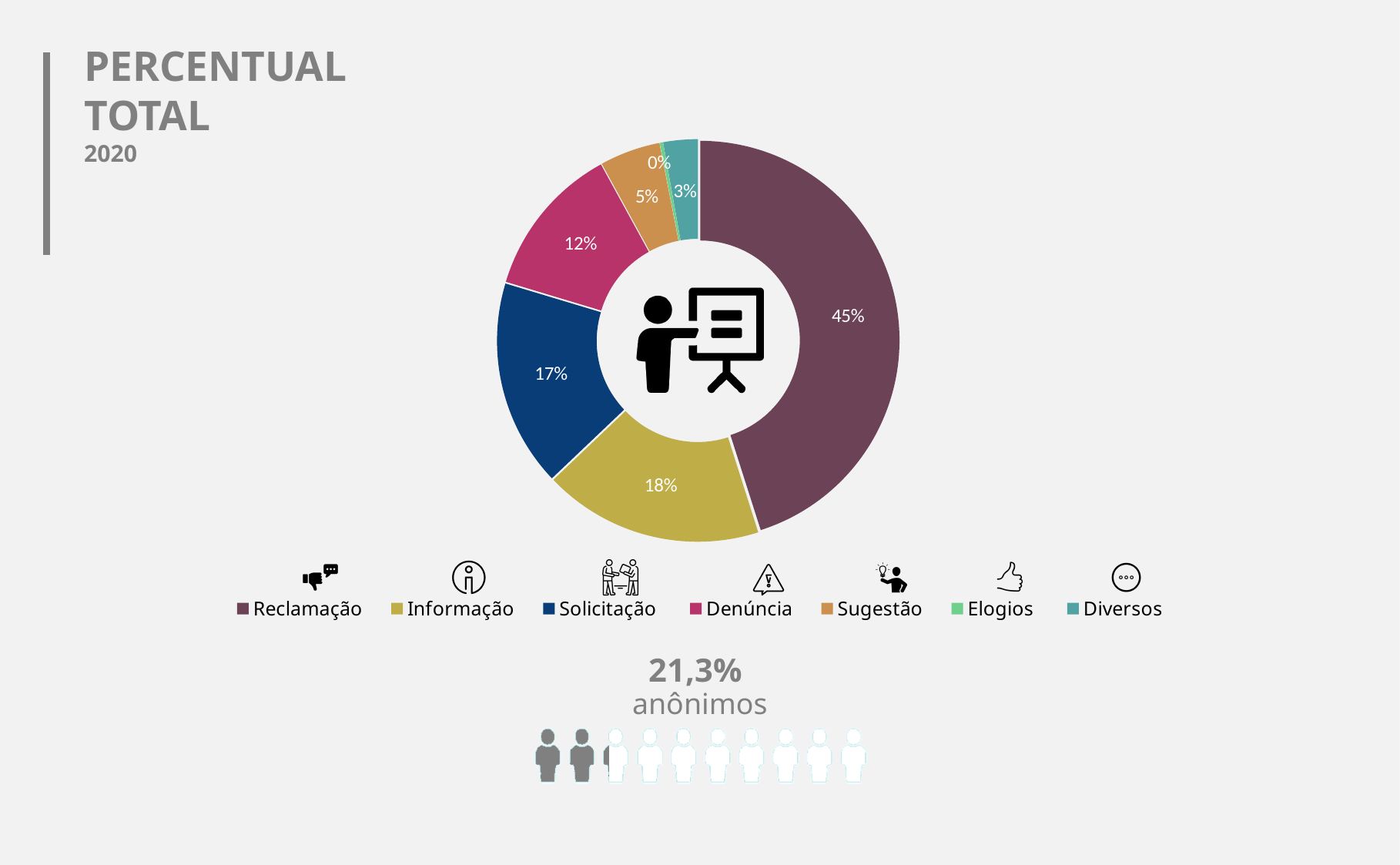
What percentage does the Informação slice represent? 18% What percentage does the Solicitação slice represent? 17% What is the title of the chart on the slide? PERCENTUAL TOTAL 2020 What is the difference in percentage points between Reclamação and Informação? 27 What percentage does the Reclamação slice represent? 45% What percentage does the Diversos slice represent? 3% What percentage does the Denúncia slice represent? 12% Which category has the largest share of the chart? Reclamação How many categories does the legend list? 7 What kind of chart is shown on the slide? Pie chart (donut) Which category has the smallest share of the chart? Elogios What percentage does the Sugestão slice represent? 5%